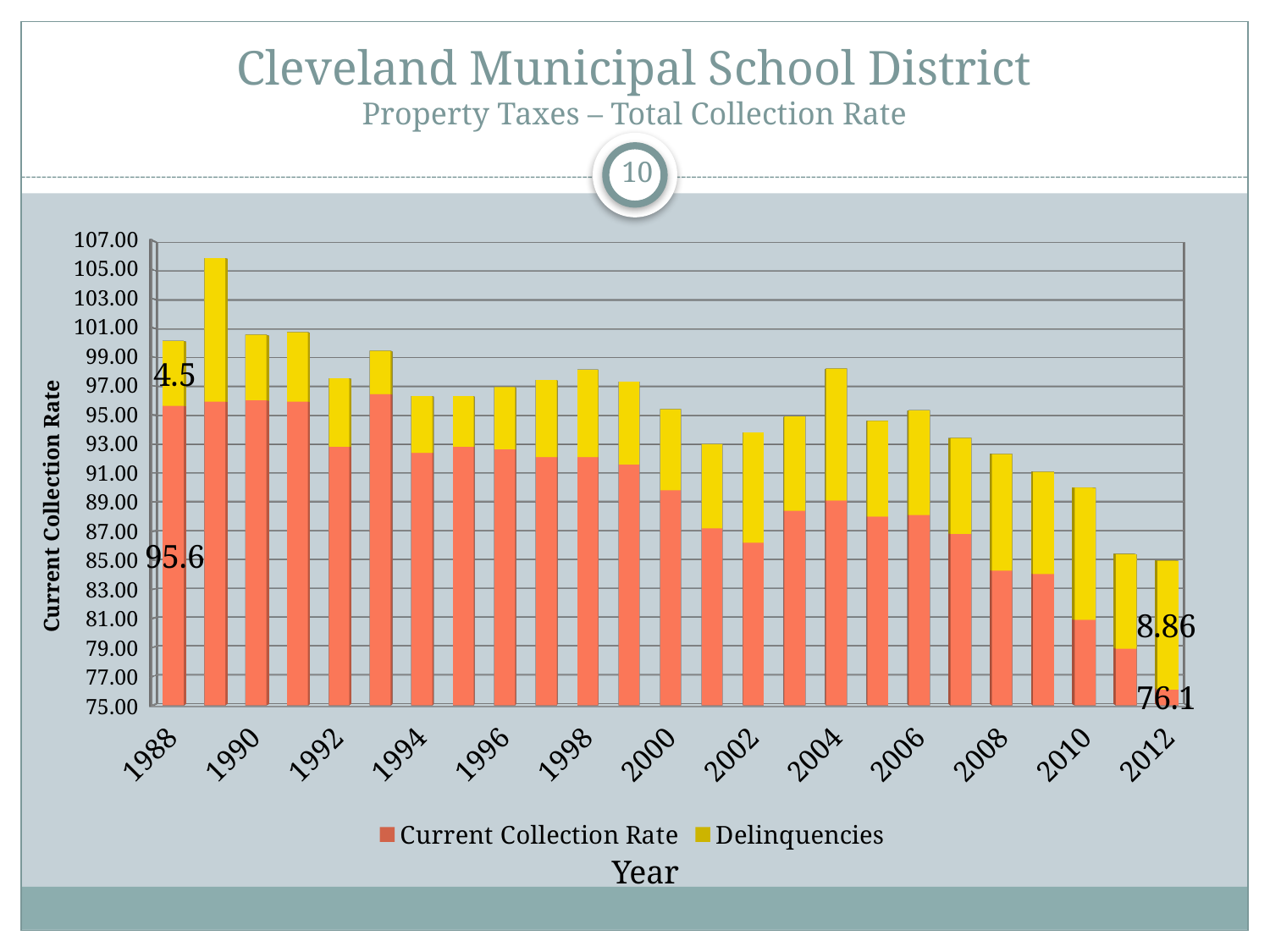
What is the Delinquencies value for 2012? 8.86 What is the Delinquencies value for 1988? 4.5 What is the Current Collection Rate for 2012? 76.1 Which year has the highest total stacked bar? 1989 How many years are plotted on the x axis? 25 What is the Current Collection Rate for 1988? 95.6 Is the Current Collection Rate for 2010 greater or less than 85.00? less What is the total height of the stacked bar for 2012 (Current Collection Rate plus Delinquencies)? 84.96 Does the Current Collection Rate generally rise or fall from 1988 to 2012? Fall What is the total height of the stacked bar for 1988 (Current Collection Rate plus Delinquencies)? 100.1 How many series does the legend list? 2 What kind of chart is shown on the slide? Stacked bar chart